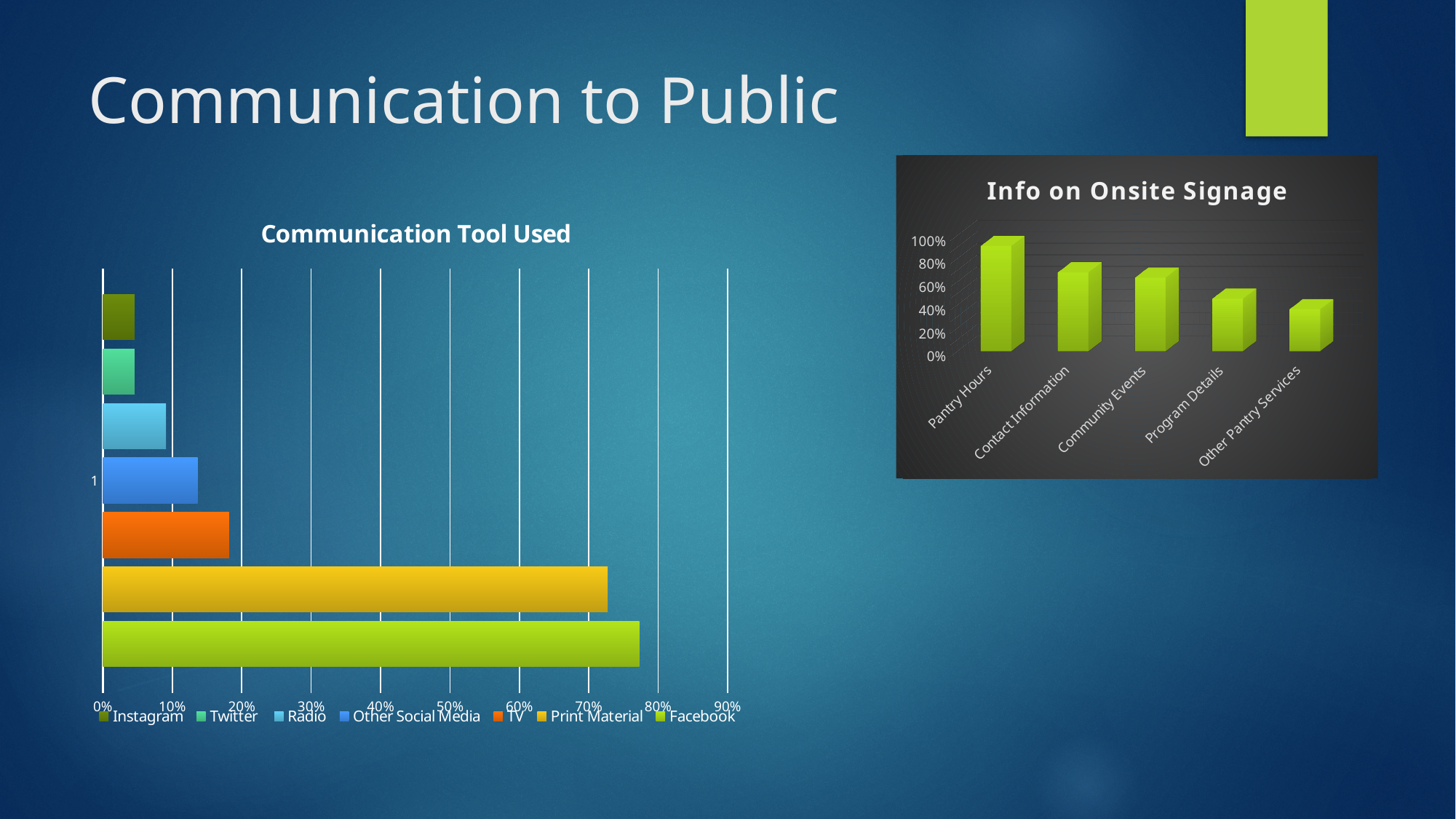
In the "Communication Tool Used" chart, which communication tool has the highest value? Facebook In the "Communication Tool Used" chart, is the value for Print Material greater or less than 70%? greater How many series does the legend of the "Communication Tool Used" chart list? 7 What kind of chart is the "Communication Tool Used" chart? bar chart In the "Info on Onsite Signage" chart, which category has the lowest value? Other Pantry Services How many categories are shown in the "Info on Onsite Signage" chart? 5 In the "Communication Tool Used" chart, is the value for Facebook greater or less than 80%? less In the "Communication Tool Used" chart, which is larger, the value for Radio or the value for Other Social Media? Other Social Media In the "Info on Onsite Signage" chart, which category has the highest value? Pantry Hours In the "Communication Tool Used" chart, is the value for TV greater or less than 20%? less In the "Info on Onsite Signage" chart, do the values rise or fall from left to right along the x axis? fall